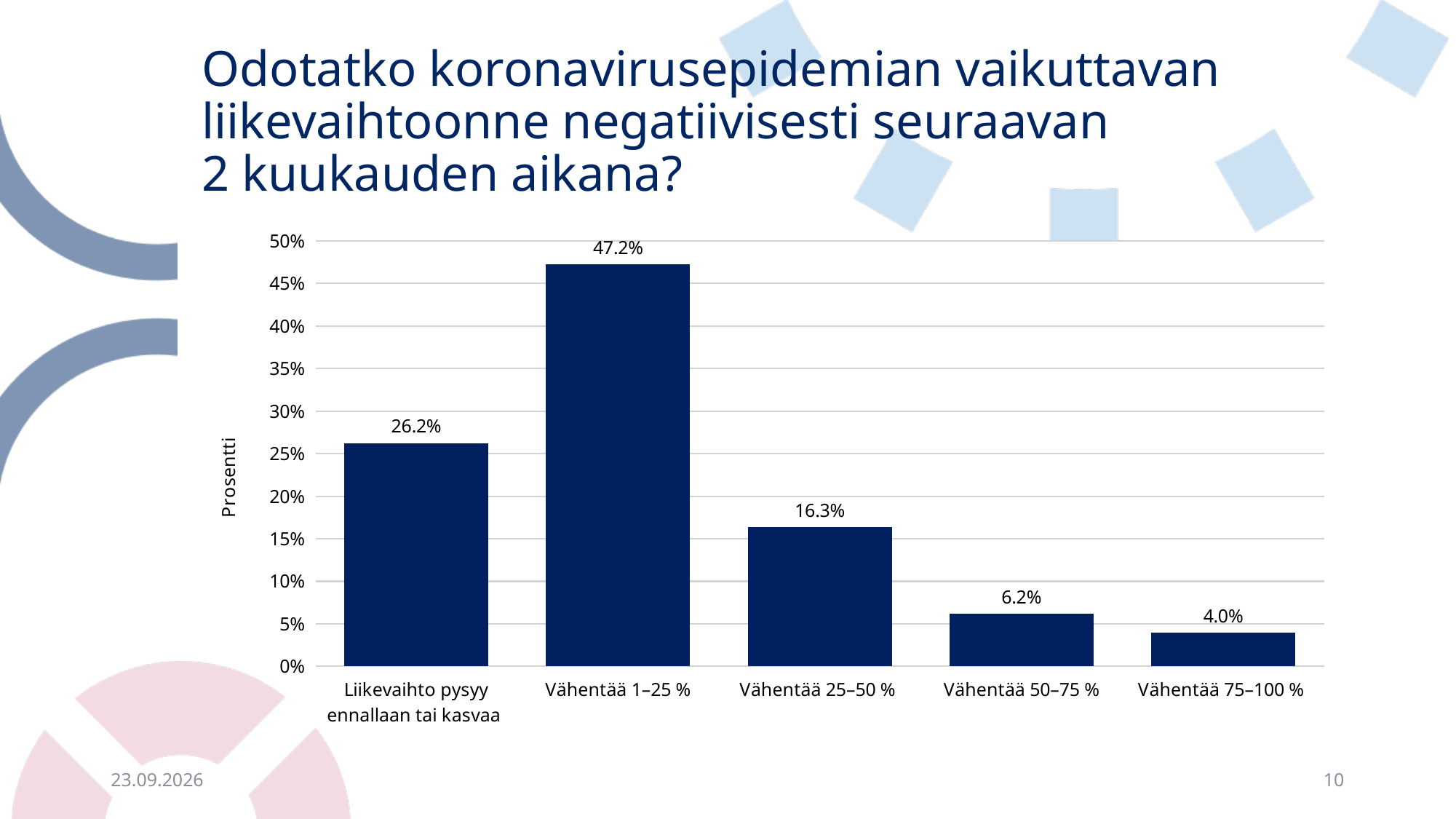
How many categories are shown on the x axis? 5 What is the value for "Vähentää 1–25 %"? 47.2% Which category has the highest value? Vähentää 1–25 % What is the label of the y axis? Prosentti What is the value for "Liikevaihto pysyy ennallaan tai kasvaa"? 26.2% What kind of chart is shown on the slide? bar chart What is the difference between the values for "Vähentää 50–75 %" and "Vähentää 75–100 %"? 2.2% What is the difference between the values for "Vähentää 1–25 %" and "Vähentää 25–50 %"? 30.9% Which category has the lowest value? Vähentää 75–100 % Is the value for "Vähentää 25–50 %" greater or less than 20%? less Which is larger: the value for "Vähentää 50–75 %" or "Vähentää 75–100 %"? Vähentää 50–75 % What is the value for "Vähentää 75–100 %"? 4.0%